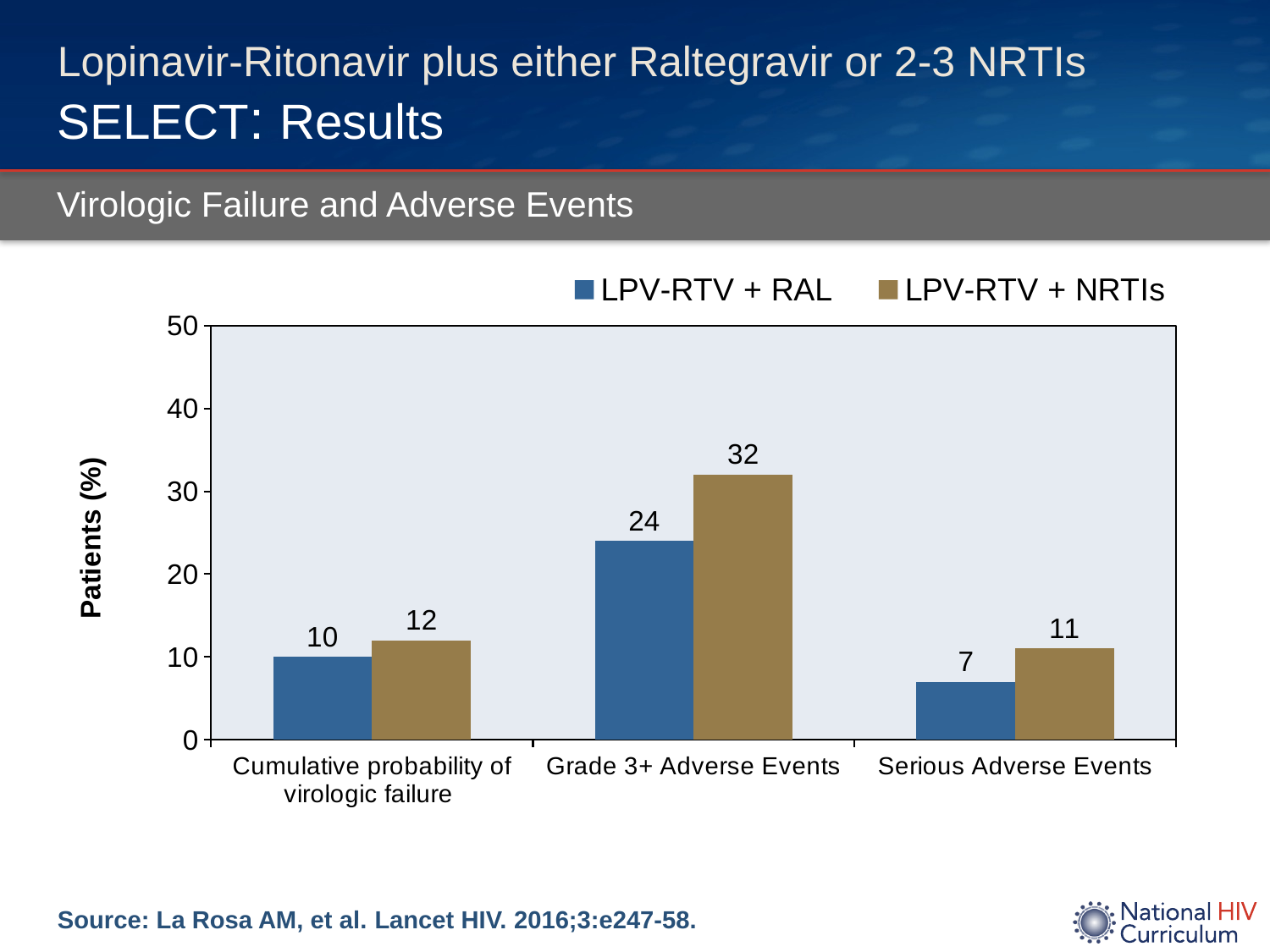
What is the value for LPV-RTV + RAL for Cumulative probability of virologic failure? 10 For Serious Adverse Events, which series has the larger value, LPV-RTV + RAL or LPV-RTV + NRTIs? LPV-RTV + NRTIs Is the value for LPV-RTV + NRTIs for Grade 3+ Adverse Events greater or less than 30? greater What is the value for LPV-RTV + NRTIs for Serious Adverse Events? 11 What kind of chart is shown on the slide? bar chart How many series does the legend list? 2 What is the value for LPV-RTV + RAL for Grade 3+ Adverse Events? 24 What is the label of the y axis? Patients (%) How many categories are shown on the x axis? 3 Which category has the highest value for LPV-RTV + NRTIs? Grade 3+ Adverse Events Which category has the lowest value for LPV-RTV + RAL? Serious Adverse Events What is the difference between LPV-RTV + NRTIs and LPV-RTV + RAL for Grade 3+ Adverse Events? 8